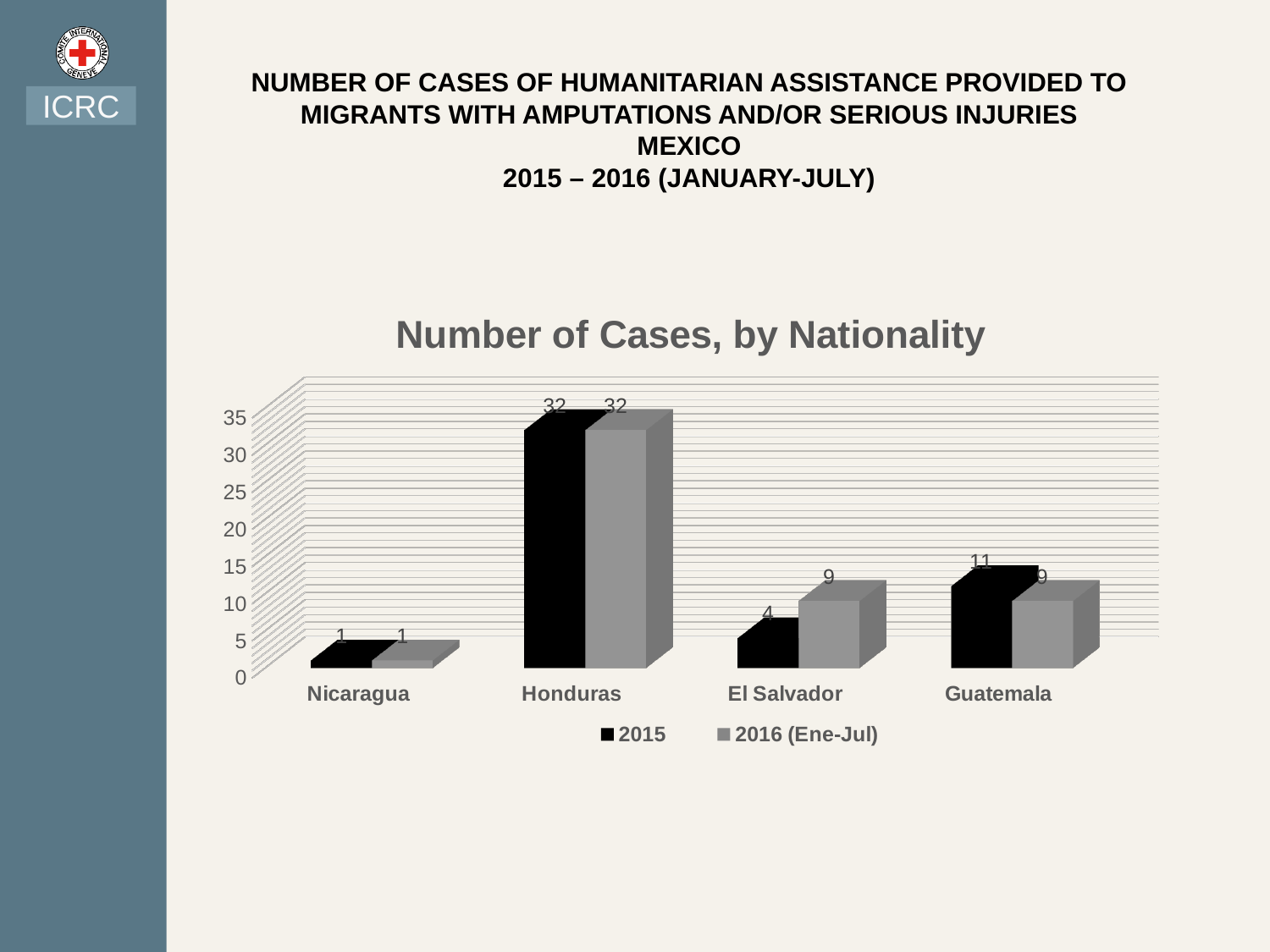
How many series does the legend list? 2 What is the 2015 value for Nicaragua? 1 Which is larger for Guatemala: the 2015 value or the 2016 (Ene-Jul) value? 2015 What is the difference between the 2015 and 2016 (Ene-Jul) values for El Salvador? 5 What is the 2015 value for Guatemala? 11 Which nationality has the highest number of cases in 2015? Honduras How many nationalities are shown on the x axis? 4 Which nationality has the lowest number of cases in 2016 (Ene-Jul)? Nicaragua What kind of chart is shown? Bar chart What is the 2016 (Ene-Jul) value for El Salvador? 9 What is the title of the chart? Number of Cases, by Nationality What is the 2015 value for Honduras? 32